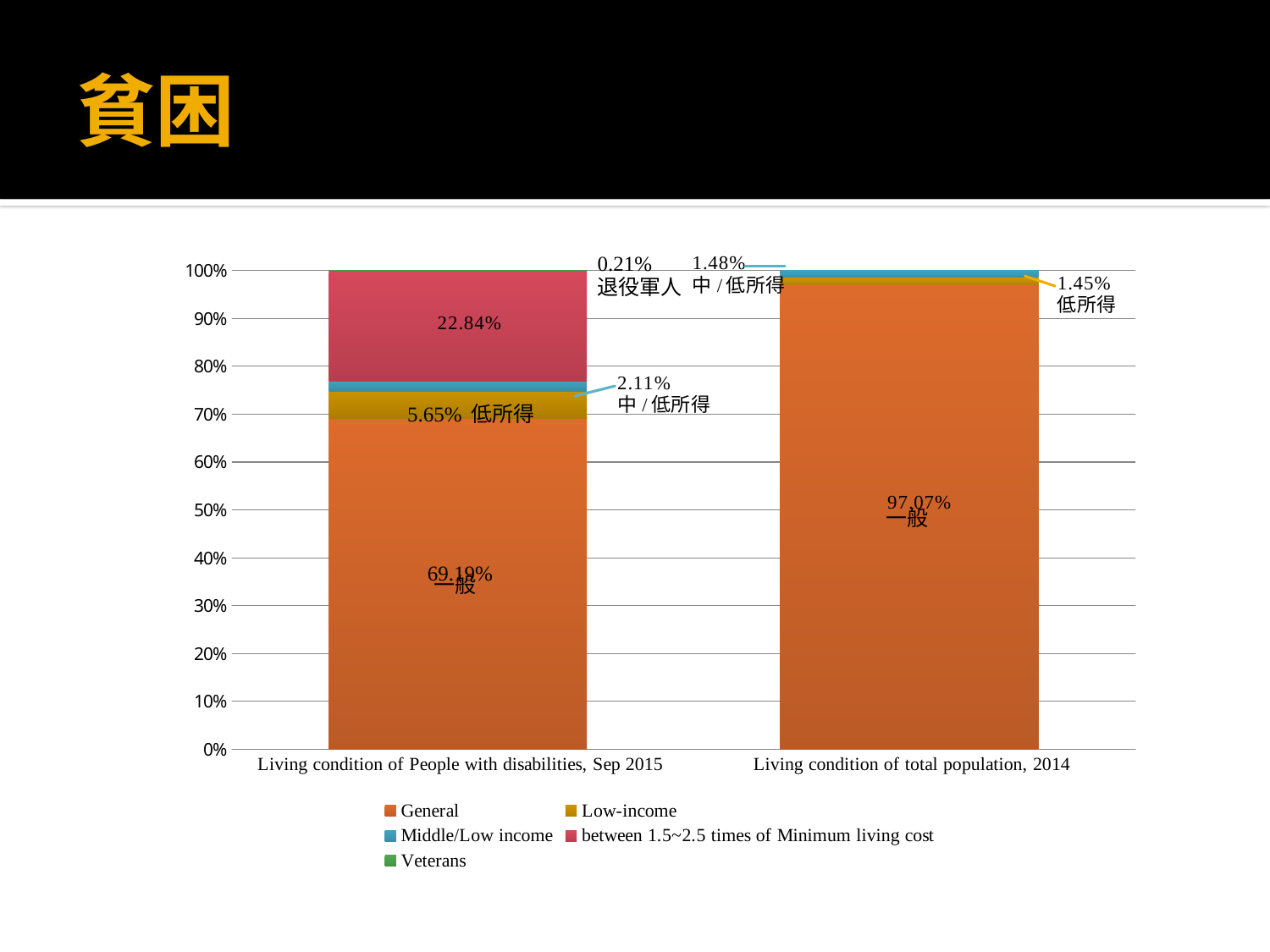
How many categories are shown on the x axis? 2 Which bar has the larger General share: people with disabilities (Sep 2015) or total population (2014)? Living condition of total population, 2014 What is the value for Low-income in the 'Living condition of People with disabilities, Sep 2015' bar? 5.65% What is the value for Low-income in the 'Living condition of total population, 2014' bar? 1.45% What is the value for Middle/Low income in the 'Living condition of total population, 2014' bar? 1.48% What is the difference between the General values for the total population (2014) and people with disabilities (Sep 2015)? 27.88% How many series does the legend list? 5 What is the value for Veterans in the 'Living condition of People with disabilities, Sep 2015' bar? 0.21% What kind of chart is shown on the slide? Stacked bar chart What is the value for General in the 'Living condition of total population, 2014' bar? 97.07% What is the value for 'between 1.5~2.5 times of Minimum living cost' in the 'Living condition of People with disabilities, Sep 2015' bar? 22.84% What is the value for General in the 'Living condition of People with disabilities, Sep 2015' bar? 69.19%